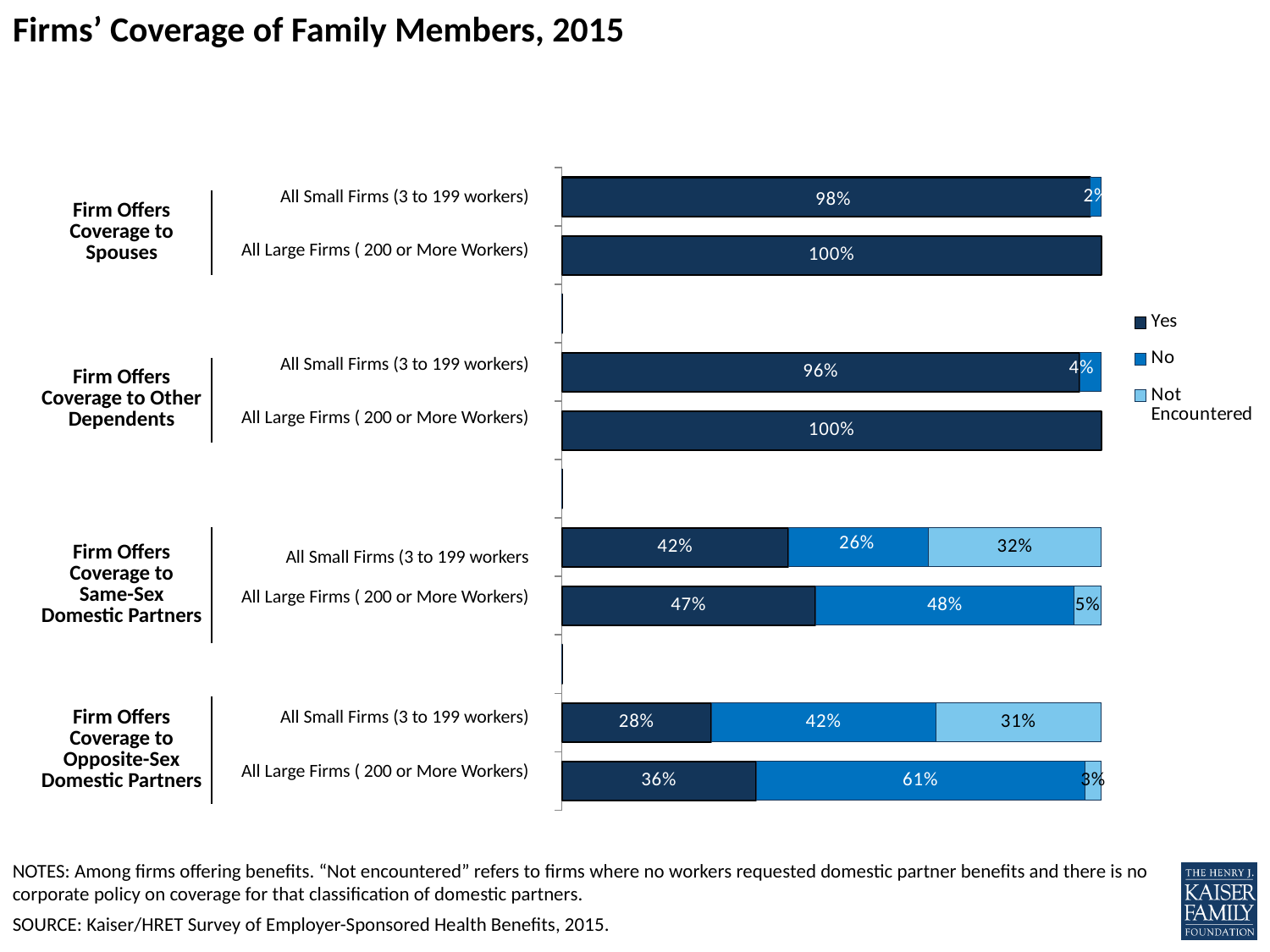
For small firms, is the "Yes" share larger for same-sex domestic partners or for opposite-sex domestic partners? Same-sex domestic partners What percentage of small firms (3 to 199 workers) answered "Yes" to offering coverage to same-sex domestic partners? 42% What kind of chart is shown on the slide? Stacked bar chart What percentage of small firms answered "No" to offering coverage to other dependents? 4% What is the difference in the "Yes" share between large firms and small firms for coverage of same-sex domestic partners? 5 percentage points What is the total of the three segments in the small firms bar for same-sex domestic partners? 100% What is the "Not Encountered" share for small firms in the opposite-sex domestic partners group? 31% Among the four coverage categories, which has the highest "Yes" share for small firms? Firm Offers Coverage to Spouses What are the three legend entries on the chart? Yes, No, Not Encountered What percentage of large firms (200 or more workers) answered "No" to offering coverage to opposite-sex domestic partners? 61% How many series does the legend list? 3 What percentage of large firms offer coverage to spouses ("Yes")? 100%